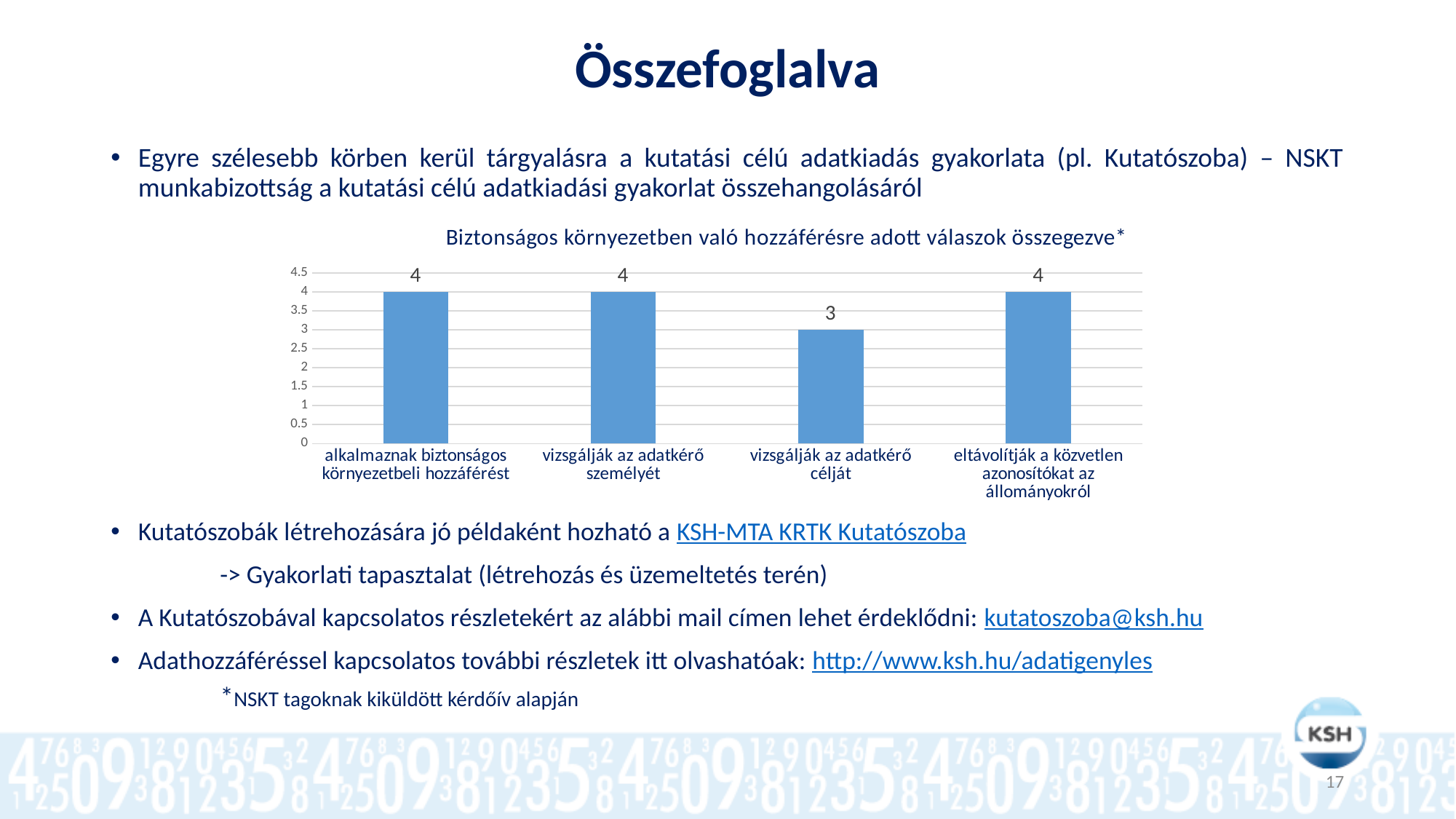
What is the difference between the value for "vizsgálják az adatkérő személyét" and the value for "vizsgálják az adatkérő célját"? 1 What is the highest value shown on the y axis? 4.5 What is the value for "vizsgálják az adatkérő célját"? 3 Which is larger: the value for "alkalmaznak biztonságos környezetbeli hozzáférést" or the value for "vizsgálják az adatkérő célját"? alkalmaznak biztonságos környezetbeli hozzáférést Which category has the lowest value? vizsgálják az adatkérő célját How many categories are shown on the x axis? 4 What is the value for "eltávolítják a közvetlen azonosítókat az állományokról"? 4 What is the title of the chart? Biztonságos környezetben való hozzáférésre adott válaszok összegezve* What kind of chart is shown on the slide? bar chart How many categories have a value of 4? 3 What is the value for "alkalmaznak biztonságos környezetbeli hozzáférést"? 4 Is the value for "vizsgálják az adatkérő célját" greater or less than 3.5? less